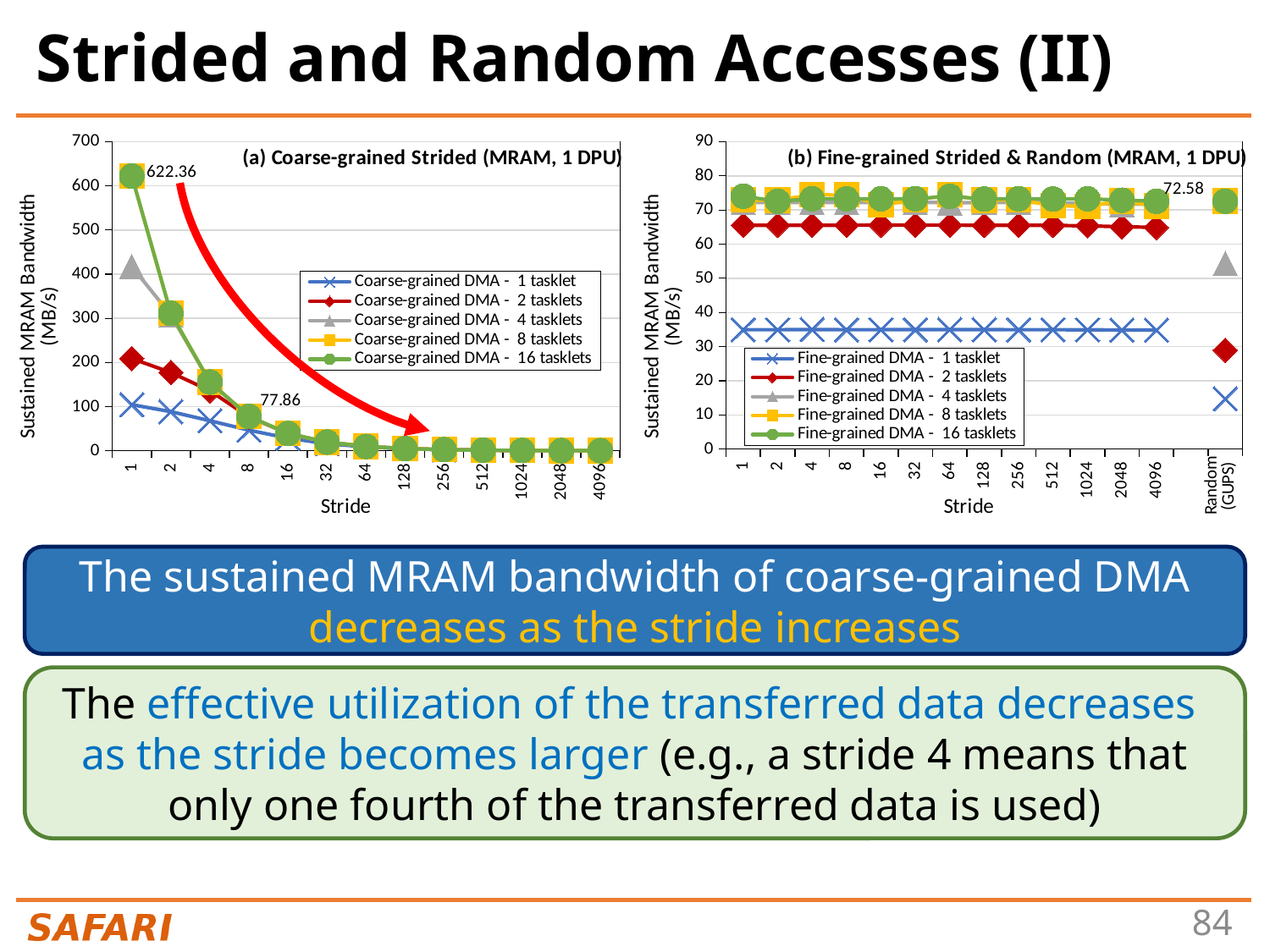
In chart (b) Fine-grained Strided & Random, how many categories are on the x axis? 14 In chart (a) Coarse-grained Strided, what is the highest value labeled at stride 1? 622.36 What kind of chart is chart (a) Coarse-grained Strided (MRAM, 1 DPU)? line chart In chart (a) Coarse-grained Strided, is the value for Coarse-grained DMA - 4 tasklets at stride 1 greater or less than 300? greater In chart (b) Fine-grained Strided & Random, is the value for Fine-grained DMA - 1 tasklet at stride 1 greater or less than 50? less In chart (a) Coarse-grained Strided, how many series does the legend list? 5 In chart (b) Fine-grained Strided & Random, which is larger at Random (GUPS): Fine-grained DMA - 4 tasklets or Fine-grained DMA - 1 tasklet? Fine-grained DMA - 4 tasklets What is the title of the chart on the right of the slide? (b) Fine-grained Strided & Random (MRAM, 1 DPU) In chart (a) Coarse-grained Strided, is the value for Coarse-grained DMA - 1 tasklet at stride 1 greater or less than 200? less In chart (a) Coarse-grained Strided, does the sustained MRAM bandwidth for 16 tasklets rise or fall as the stride increases? fall In chart (a) Coarse-grained Strided, how many stride values are on the x axis? 13 In chart (b) Fine-grained Strided & Random, what value is labeled at stride 4096? 72.58